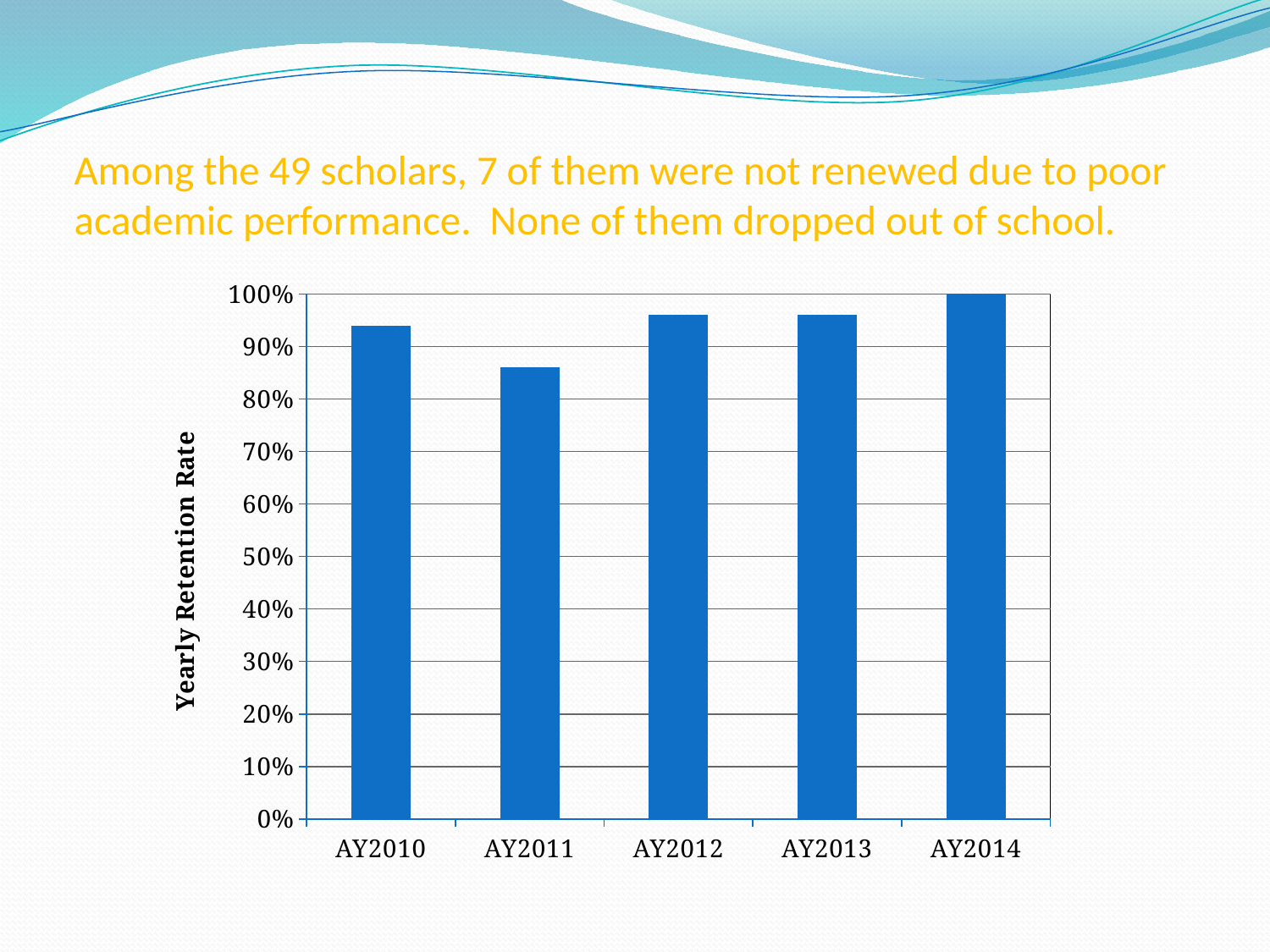
Is the yearly retention rate for AY2012 greater or less than 90%? greater What colour are the bars in the chart? Blue Which has the higher yearly retention rate, AY2013 or AY2014? AY2014 Which has the higher yearly retention rate, AY2010 or AY2011? AY2010 How many academic years are plotted on the chart? 5 What is the yearly retention rate for AY2014? 100% Is the yearly retention rate for AY2011 greater or less than 90%? less What is the label on the vertical axis of the chart? Yearly Retention Rate Which academic year has the lowest yearly retention rate? AY2011 Is the yearly retention rate for AY2010 greater or less than 90%? greater Which academic year has the highest yearly retention rate? AY2014 What kind of chart is shown on the slide? Bar chart